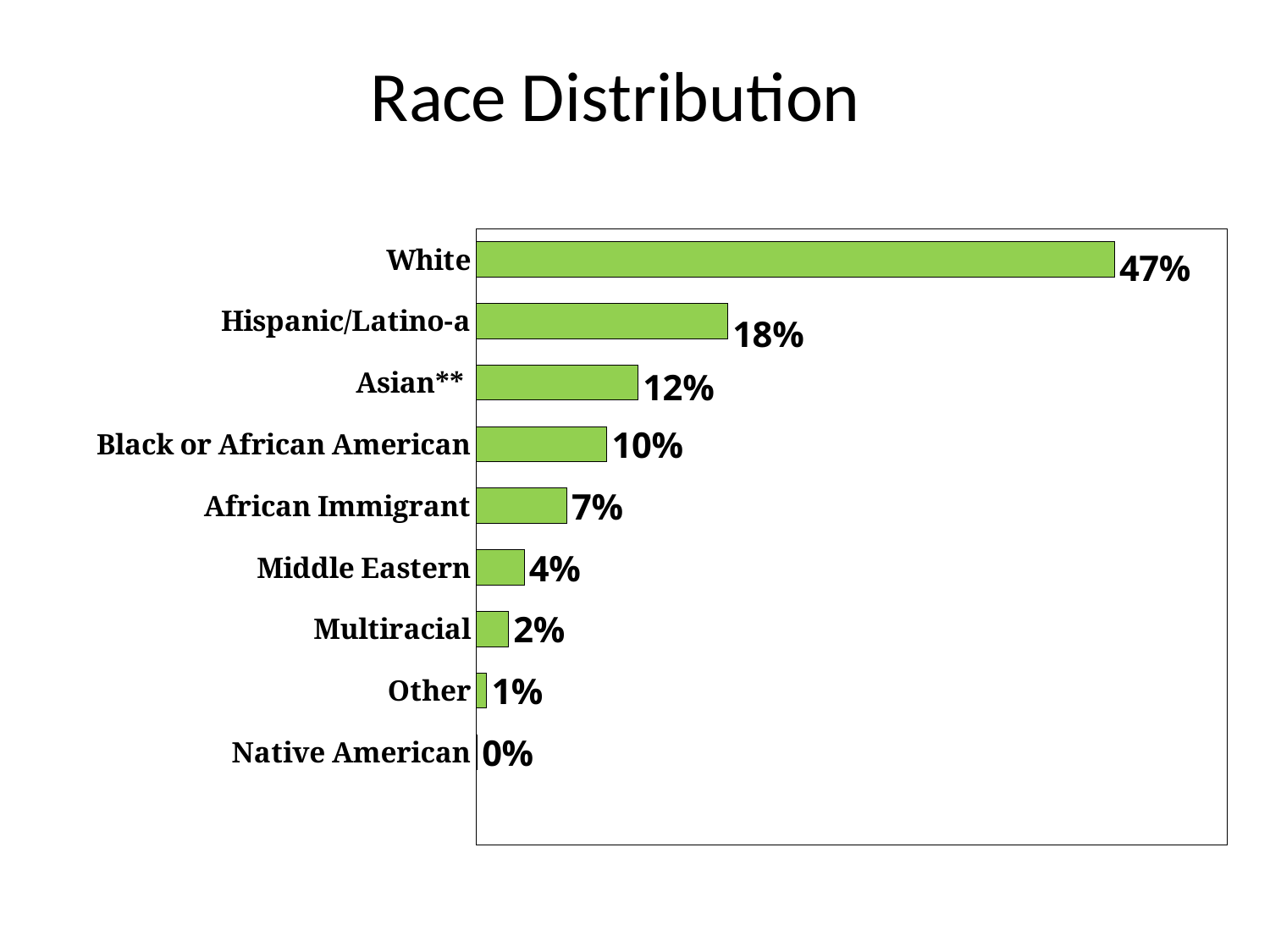
What is the difference between the values for White and Hispanic/Latino-a? 29% What is the value for Black or African American? 10% Which category has the lowest value? Native American What is the value for Hispanic/Latino-a? 18% What is the value for Middle Eastern? 4% What is the title of the slide? Race Distribution What is the difference between the values for Asian** and African Immigrant? 5% What kind of chart is shown on the slide? Bar chart What is the value for White? 47% How many categories are shown in the chart? 9 Which is larger, the value for Multiracial or the value for Other? Multiracial Which category has the highest value? White